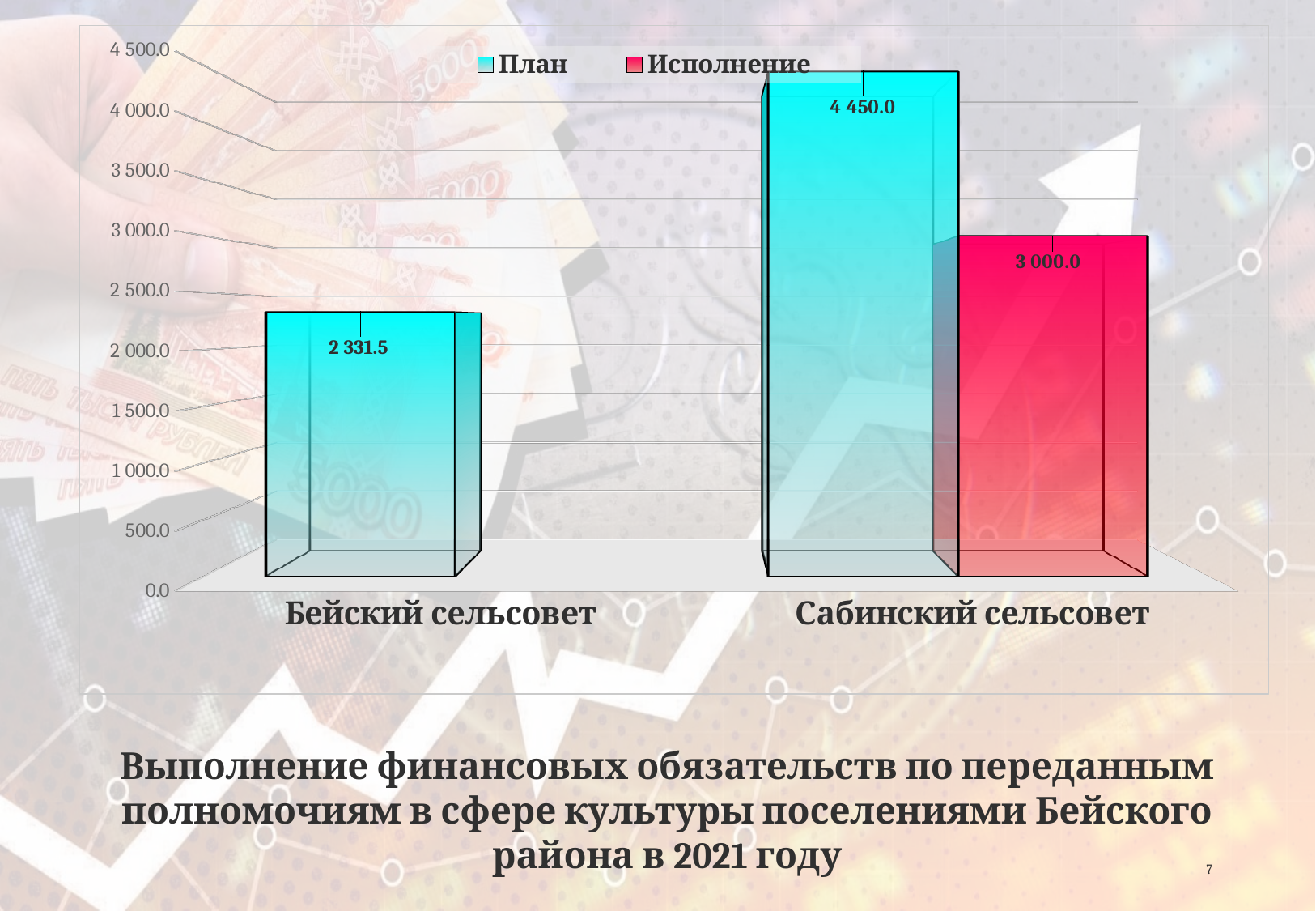
What is the План value for Сабинский сельсовет? 4 450.0 What is the difference between the План and Исполнение values for Сабинский сельсовет? 1 450.0 What is the План value for Бейский сельсовет? 2 331.5 How many categories are shown on the x axis? 2 What is the Исполнение value for Сабинский сельсовет? 3 000.0 Which category has the lowest План value? Бейский сельсовет How many series does the legend list? 2 Which category has the highest План value? Сабинский сельсовет Which is larger for Сабинский сельсовет: План or Исполнение? План What is the difference between the План values for Сабинский сельсовет and Бейский сельсовет? 2 118.5 Is the План value for Бейский сельсовет greater or less than 2 500.0? less What kind of chart is shown on the slide? bar chart